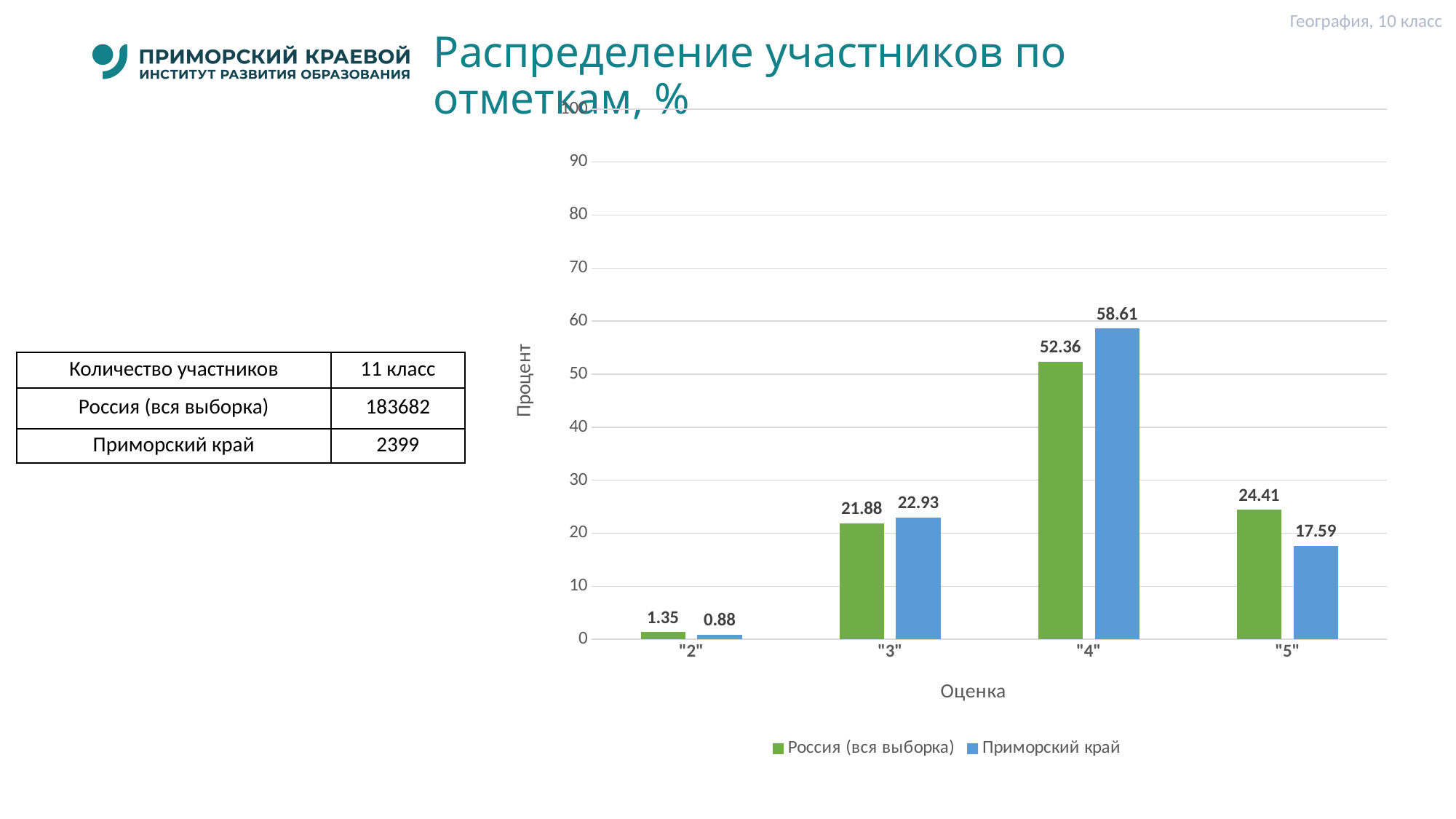
How many series does the chart legend list? 2 What is the label of the y axis of the chart? Процент What type of chart is shown on the slide? bar chart Which grade has the lowest value for Приморский край? "2" Which grade has the highest value for Россия (вся выборка)? "4" What is the value for Приморский край for grade "2"? 0.88 What is the difference between Приморский край and Россия (вся выборка) for grade "4"? 6.25 Is the value for Приморский край for grade "3" greater or less than 20? greater What is the value for Россия (вся выборка) for grade "3"? 21.88 For grade "5", which series has the larger value: Россия (вся выборка) or Приморский край? Россия (вся выборка) How many grade categories are shown on the x axis of the chart? 4 What is the value for Приморский край for grade "4"? 58.61